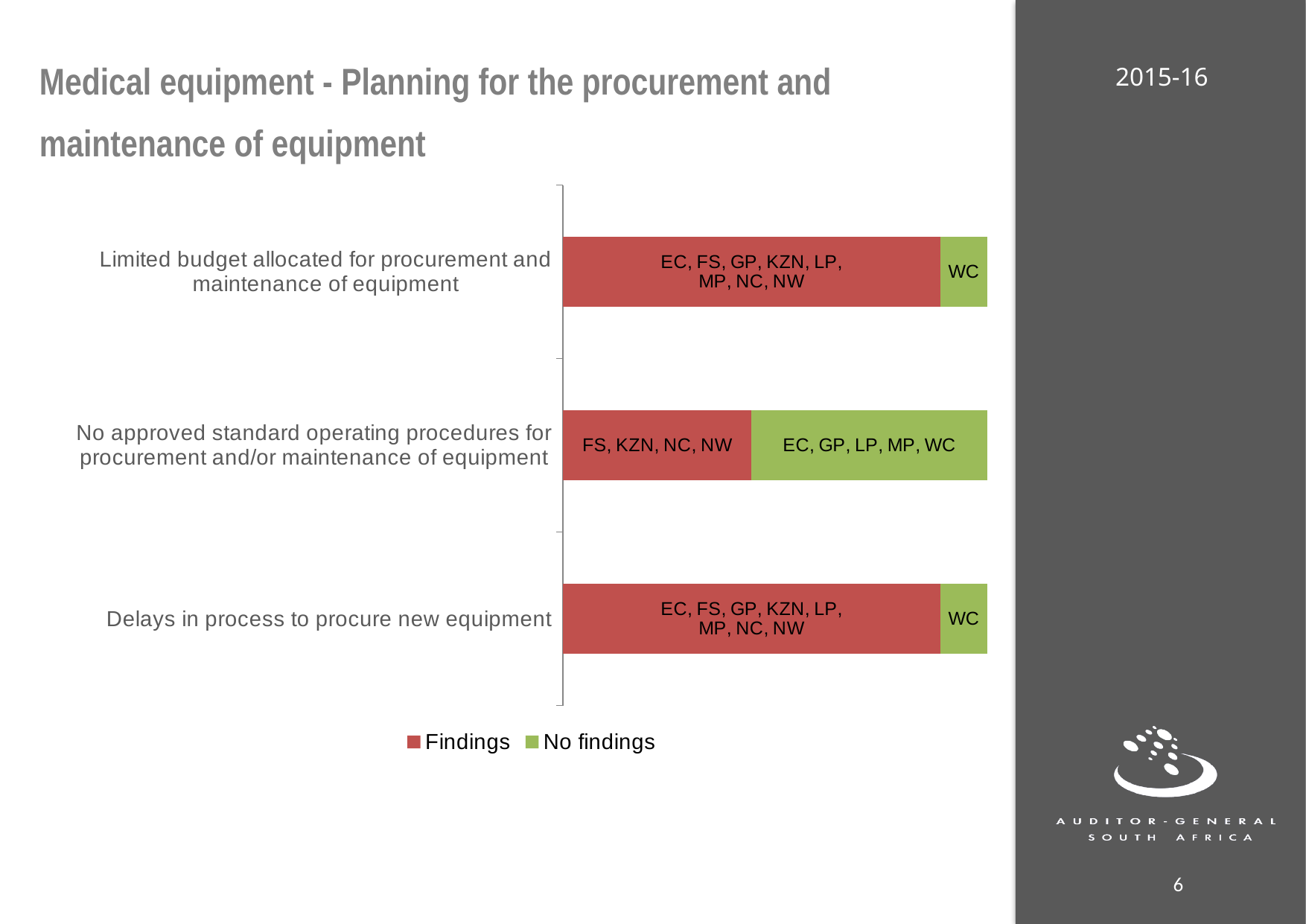
Which provinces are labelled in the 'No findings' segment for 'No approved standard operating procedures for procurement and/or maintenance of equipment'? EC, GP, LP, MP, WC What year is shown in the top right corner of the slide? 2015-16 How many series does the legend list? 2 For 'Delays in process to procure new equipment', which segment is larger: 'Findings' or 'No findings'? Findings Which provinces are labelled in the 'Findings' segment for 'No approved standard operating procedures for procurement and/or maintenance of equipment'? FS, KZN, NC, NW Which category has the largest 'No findings' segment? No approved standard operating procedures for procurement and/or maintenance of equipment What kind of chart is shown on the slide? Stacked bar chart Which provinces are labelled in the 'Findings' segment for 'Delays in process to procure new equipment'? EC, FS, GP, KZN, LP, MP, NC, NW How many categories (findings) are plotted on the chart? 3 What colour represents the 'Findings' series in the legend? Red Which provinces are labelled in the 'No findings' segment for 'Limited budget allocated for procurement and maintenance of equipment'? WC For 'No approved standard operating procedures for procurement and/or maintenance of equipment', which segment is larger: 'Findings' or 'No findings'? No findings